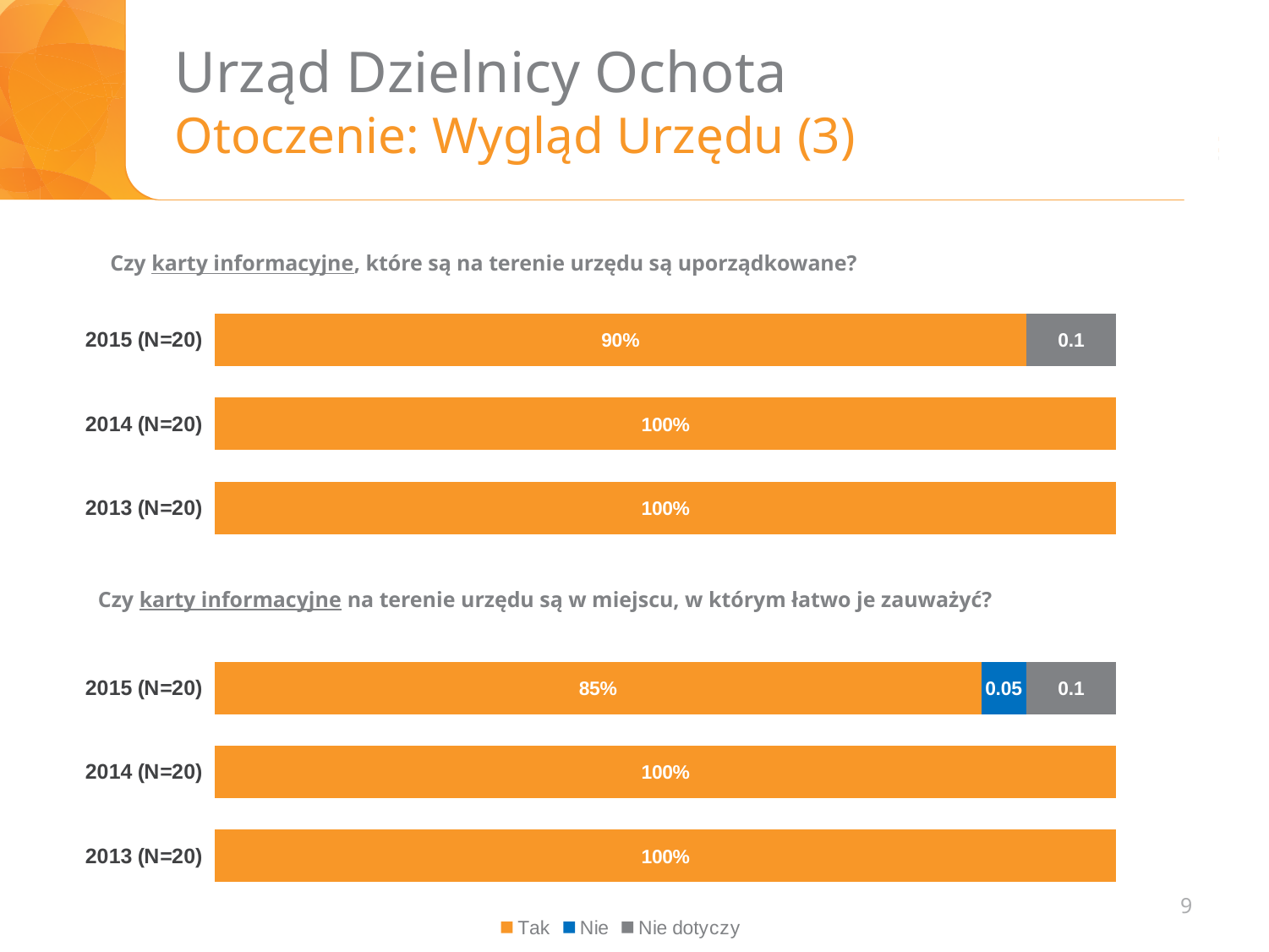
In the top chart, what is the 'Tak' value for 2014 (N=20)? 100% In the top chart, what is the 'Tak' value for 2015 (N=20)? 90% In the top chart, which year has the lowest 'Tak' value? 2015 (N=20) In the bottom chart, what is the 'Nie' value for 2015 (N=20)? 0.05 In the top chart, what is the difference between the 'Tak' value for 2014 (N=20) and the 'Tak' value for 2015 (N=20)? 10% In the bottom chart, what is the 'Tak' value for 2015 (N=20)? 85% In the top chart, what is the 'Nie dotyczy' value for 2015 (N=20)? 0.1 How many series does the legend list? 3 What kind of chart is the bottom chart? Bar chart How many year categories are shown in the top chart? 3 In the bottom chart, what is the 'Tak' value for 2013 (N=20)? 100% In the bottom chart, which year has the lowest 'Tak' value? 2015 (N=20)